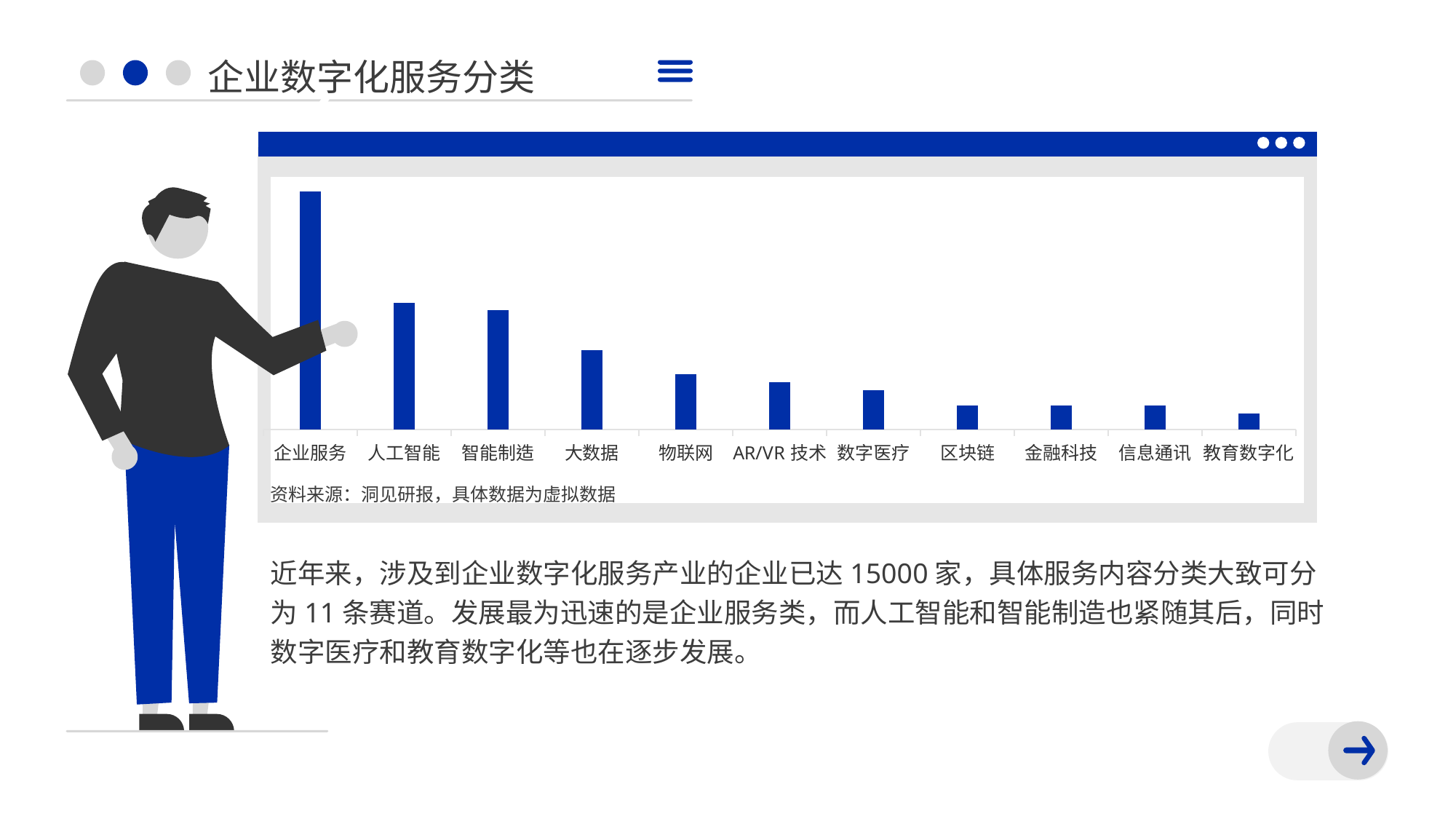
How many categories are plotted on the bar chart? 11 Which category has the highest bar in the chart? 企业服务 What source note is printed below the chart? 资料来源：洞见研报，具体数据为虚拟数据 Do the bar values rise or fall moving from left to right along the x axis? Fall What is the title of the slide containing the chart? 企业数字化服务分类 Which has the larger value, 数字医疗 or 智能制造? 智能制造 Which has the larger value, 企业服务 or 人工智能? 企业服务 What kind of chart is shown on the slide? Bar chart Which category is the second highest in the chart? 人工智能 Which category has the lowest bar in the chart? 教育数字化 Which has the larger value, 大数据 or 物联网? 大数据